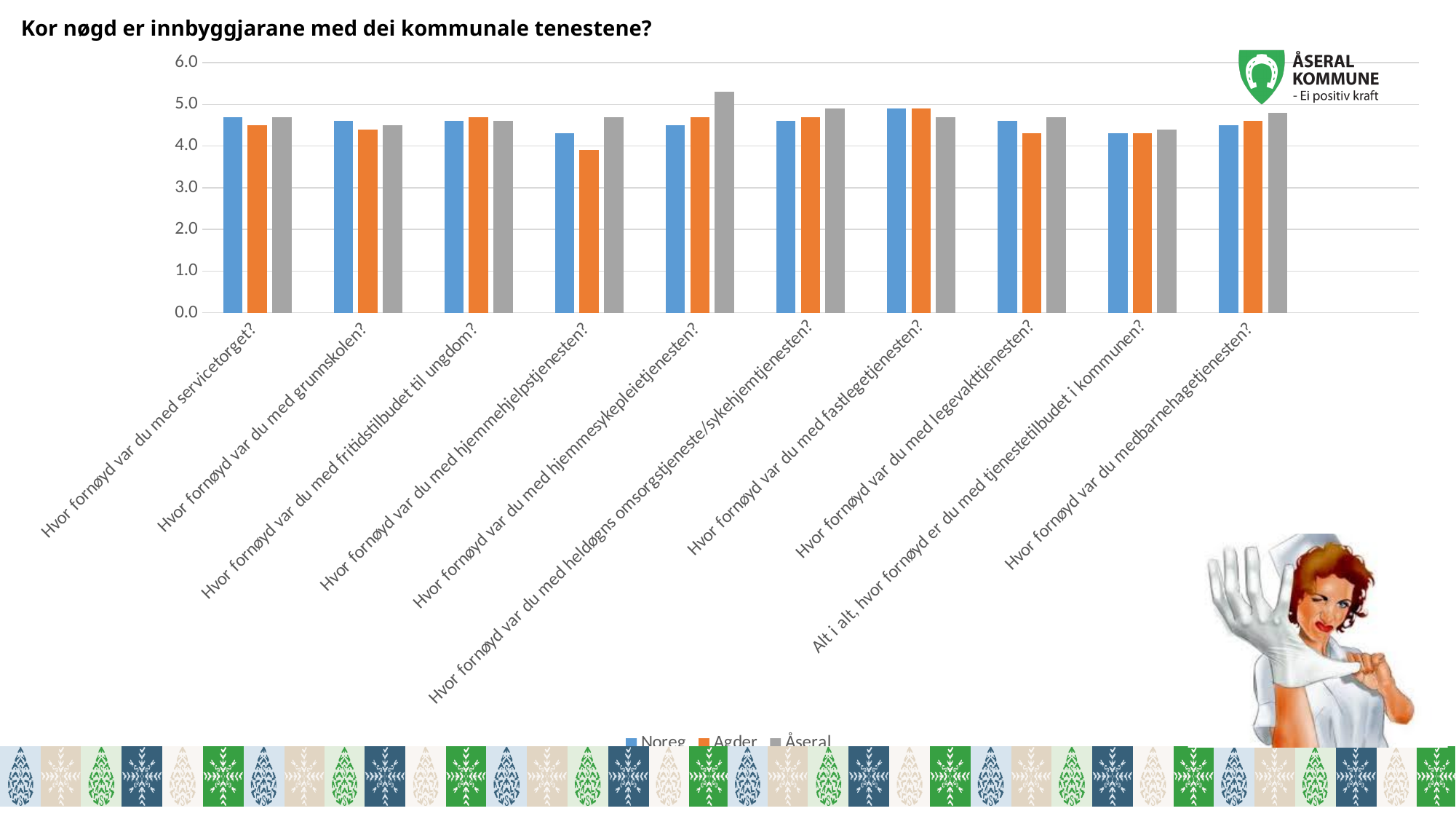
How many series does the legend list? 3 What kind of chart is shown on the slide? bar chart For 'Hvor fornøyd var du med heldøgns omsorgstjeneste/sykehjemtjenesten?', which is larger: the Noreg value or the Åseral value? Åseral Is the Åseral value for 'Hvor fornøyd var du med heldøgns omsorgstjeneste/sykehjemtjenesten?' greater or less than 5.0? less What is the title of the chart? Kor nøgd er innbyggjarane med dei kommunale tenestene? How many question categories are plotted along the x axis? 10 Which series and category has the lowest bar in the chart? Agder, Hvor fornøyd var du med hjemmehjelpstjenesten? Which series is shown in orange in the legend? Agder Which series and category has the highest bar in the chart? Åseral, Hvor fornøyd var du med hjemmesykepleietjenesten? Is the Agder value for 'Hvor fornøyd var du med hjemmehjelpstjenesten?' greater or less than 4.0? less Is the Noreg value for 'Hvor fornøyd var du med servicetorget?' greater or less than 4.0? greater For 'Hvor fornøyd var du med hjemmehjelpstjenesten?', which is larger: the Åseral value or the Agder value? Åseral